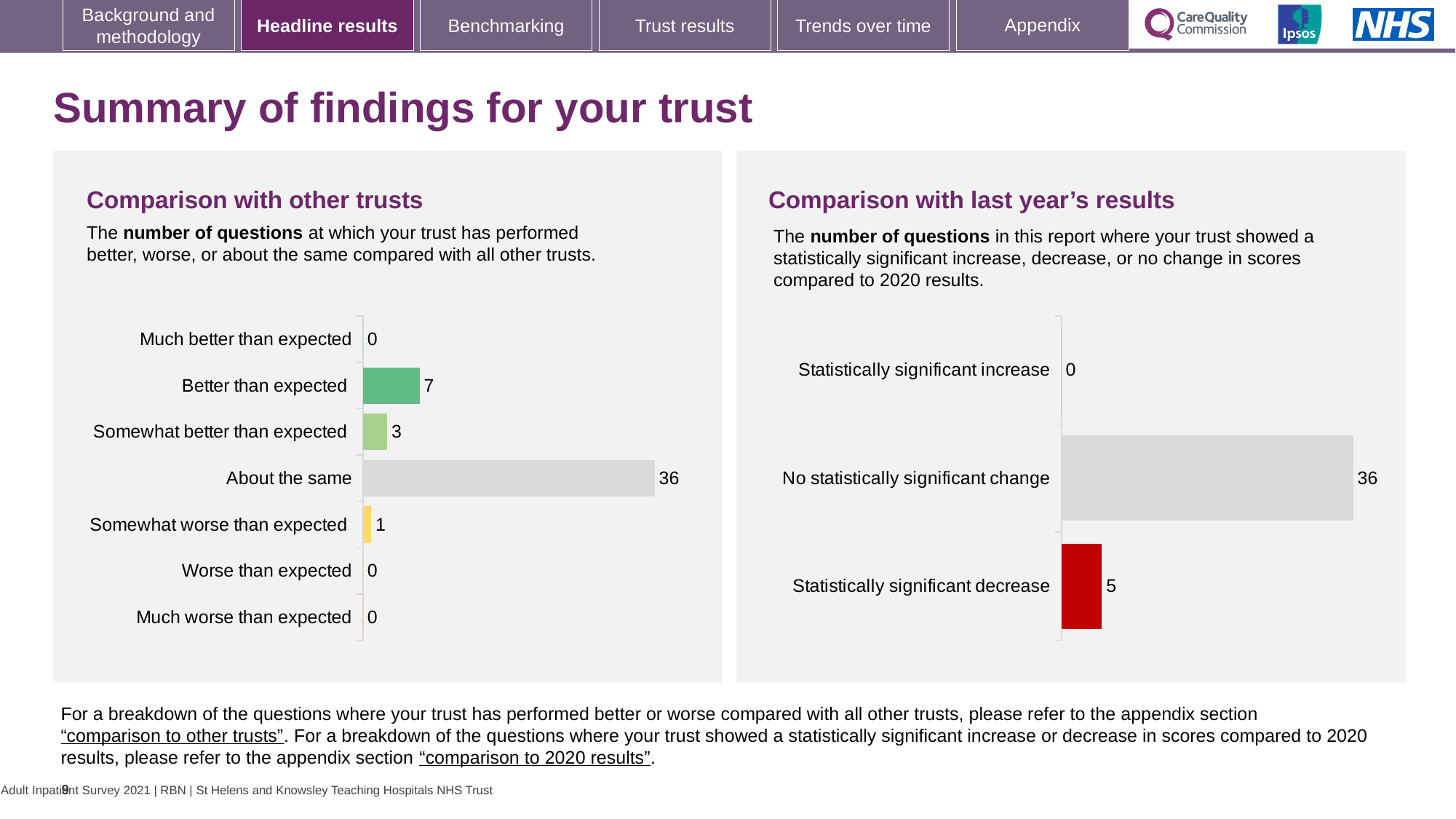
In the 'Comparison with other trusts' chart, how many questions are 'Better than expected'? 7 In the 'Comparison with other trusts' chart, which category has the highest number of questions? About the same In the 'Comparison with other trusts' chart, which is larger: 'Somewhat better than expected' or 'Somewhat worse than expected'? Somewhat better than expected What type of chart is used in the 'Comparison with last year's results' panel? Bar chart In the 'Comparison with other trusts' chart, how many questions are 'Somewhat worse than expected'? 1 In the 'Comparison with other trusts' chart, what is the difference between 'Better than expected' and 'Somewhat better than expected'? 4 In the 'Comparison with last year's results' chart, how many questions showed a statistically significant decrease? 5 In the 'Comparison with other trusts' chart, how many categories are shown? 7 In the 'Comparison with last year's results' chart, how many questions showed no statistically significant change? 36 In the 'Comparison with last year's results' chart, which category has the lowest value? Statistically significant increase In the 'Comparison with last year's results' chart, what is the difference between 'No statistically significant change' and 'Statistically significant decrease'? 31 In the 'Comparison with other trusts' chart, how many questions are 'About the same'? 36